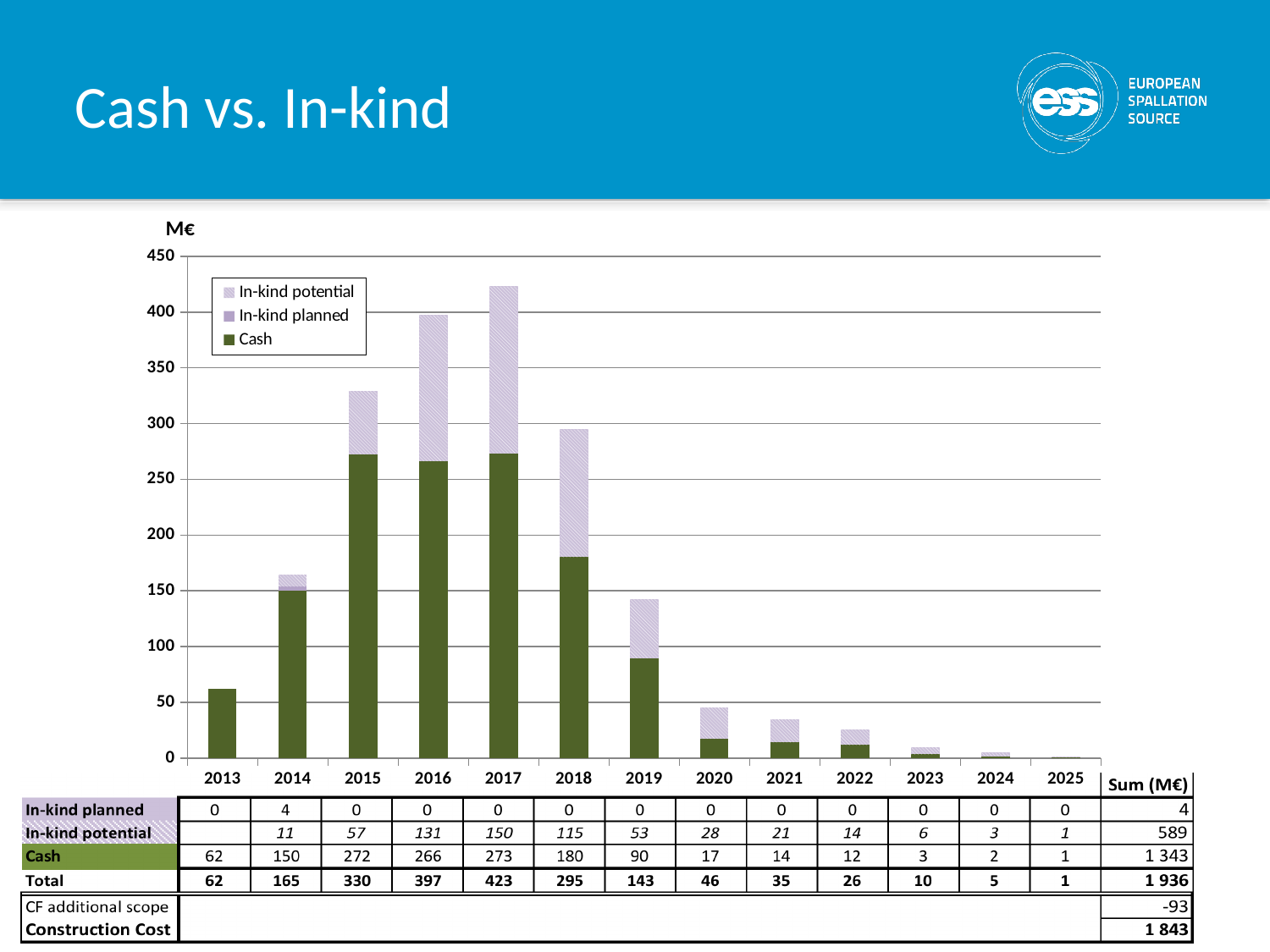
What is the In-kind planned value for 2014? 4 Which year has the lowest Total? 2025 What is the total of the stacked bar for 2018? 295 Do the Total values rise or fall from 2018 to 2025? Fall What is the difference between the Cash values for 2015 and 2018? 92 What kind of chart is shown on the slide? Stacked bar chart What is the In-kind potential value for 2016? 131 How many series does the legend list? 3 Is the Cash value for 2016 or 2019 larger? 2016 How many years are shown on the x axis? 13 Which year has the highest Total? 2017 What is the Cash value for 2017? 273